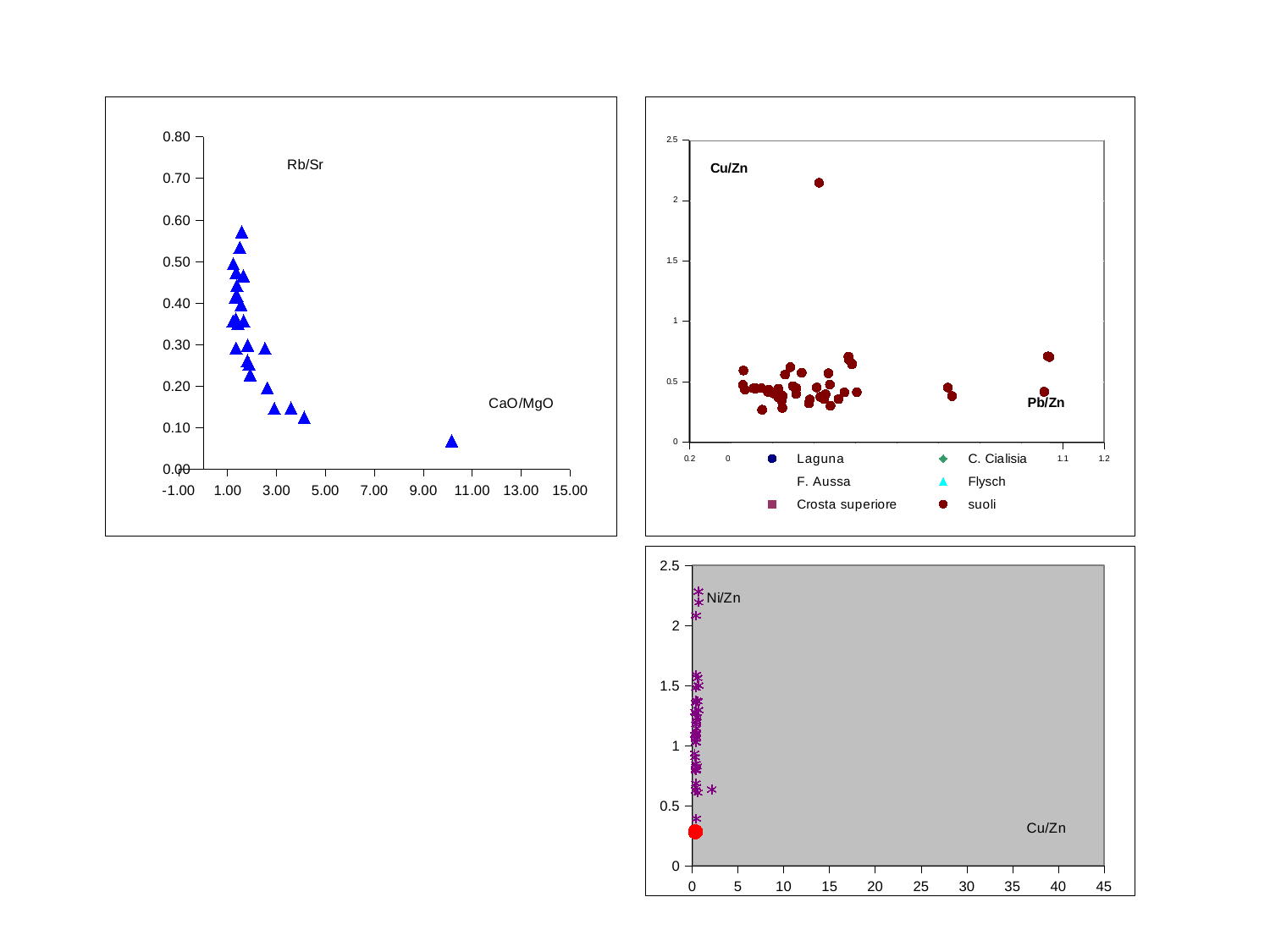
What is the maximum value shown on the horizontal axis of the bottom-right chart (Ni/Zn vs Cu/Zn)? 45 In the top-right chart (Cu/Zn vs Pb/Zn), is the highest Cu/Zn value greater or less than 2? greater In the top-left chart, what quantity is plotted on the horizontal axis? CaO/MgO In the top-left chart, is the Rb/Sr value of the isolated point near CaO/MgO 10 greater or less than 0.10? less How many series does the legend of the top-right chart (Cu/Zn vs Pb/Zn) list? 6 What kind of chart is the top-right chart with the Cu/Zn and Pb/Zn labels? scatter chart In the bottom-right chart (Ni/Zn vs Cu/Zn), is the highest Ni/Zn value greater or less than 2? greater In the top-left chart, what quantity is plotted on the vertical axis? Rb/Sr In the top-left chart, do the Rb/Sr values rise or fall as CaO/MgO increases? fall What kind of chart is the top-left chart with the Rb/Sr label? scatter chart What kind of chart is the bottom-right chart with the Ni/Zn label? scatter chart